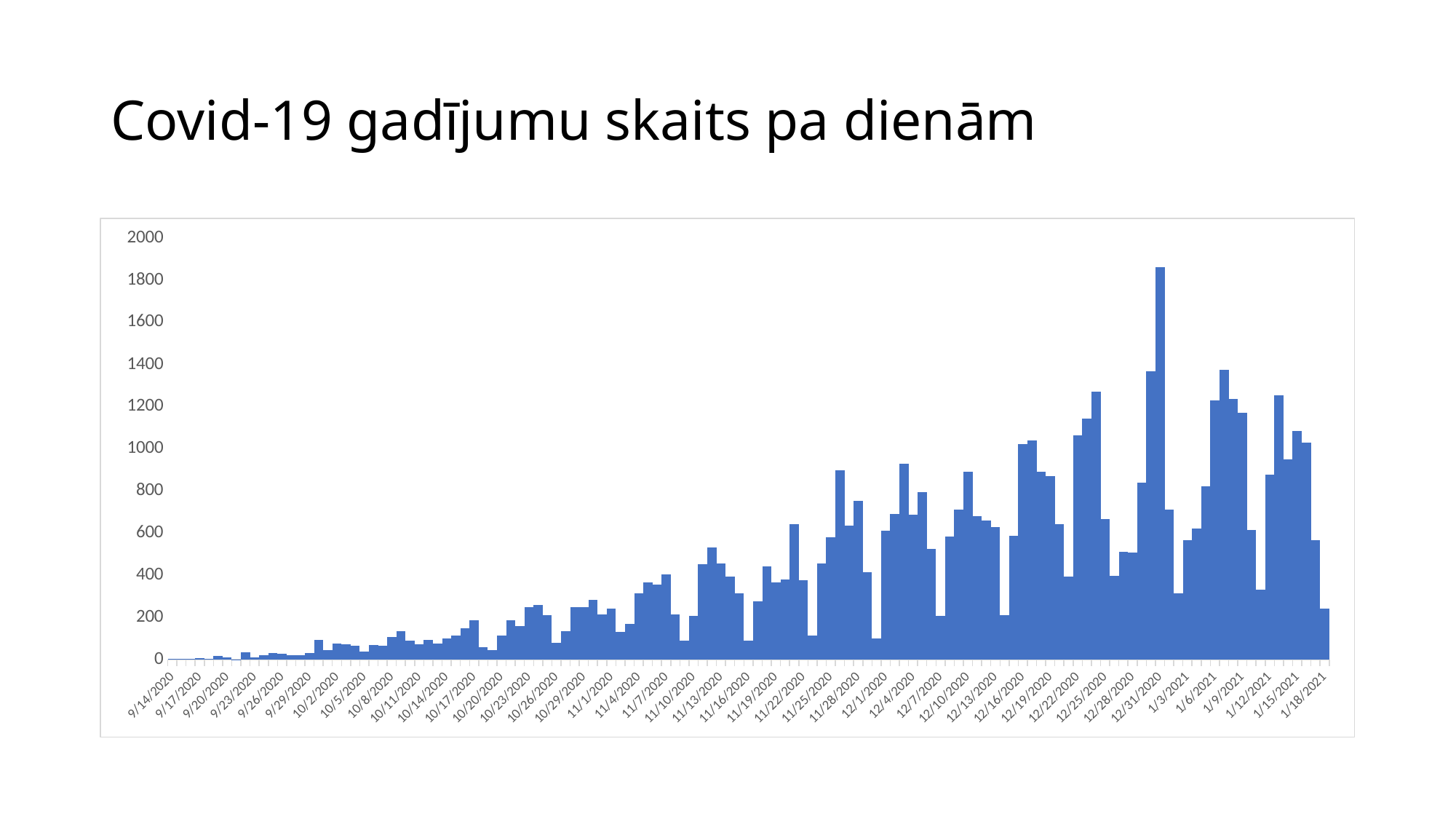
Is the highest bar in the chart greater or less than 1800? greater Which date has the larger value, 9/14/2020 or 1/18/2021? 1/18/2021 Is the value for 1/18/2021 greater or less than 400? less Do the daily case values generally rise or fall from September 2020 to January 2021? rise What is the title of the chart on the slide? Covid-19 gadījumu skaits pa dienām What kind of chart is shown on the slide? bar chart How many data series are plotted in the chart? 1 What is the highest value shown on the vertical axis of the chart? 2000 What is the first date shown on the x axis of the chart? 9/14/2020 Is the value for 9/14/2020 greater or less than 200? less What is the last date shown on the x axis of the chart? 1/18/2021